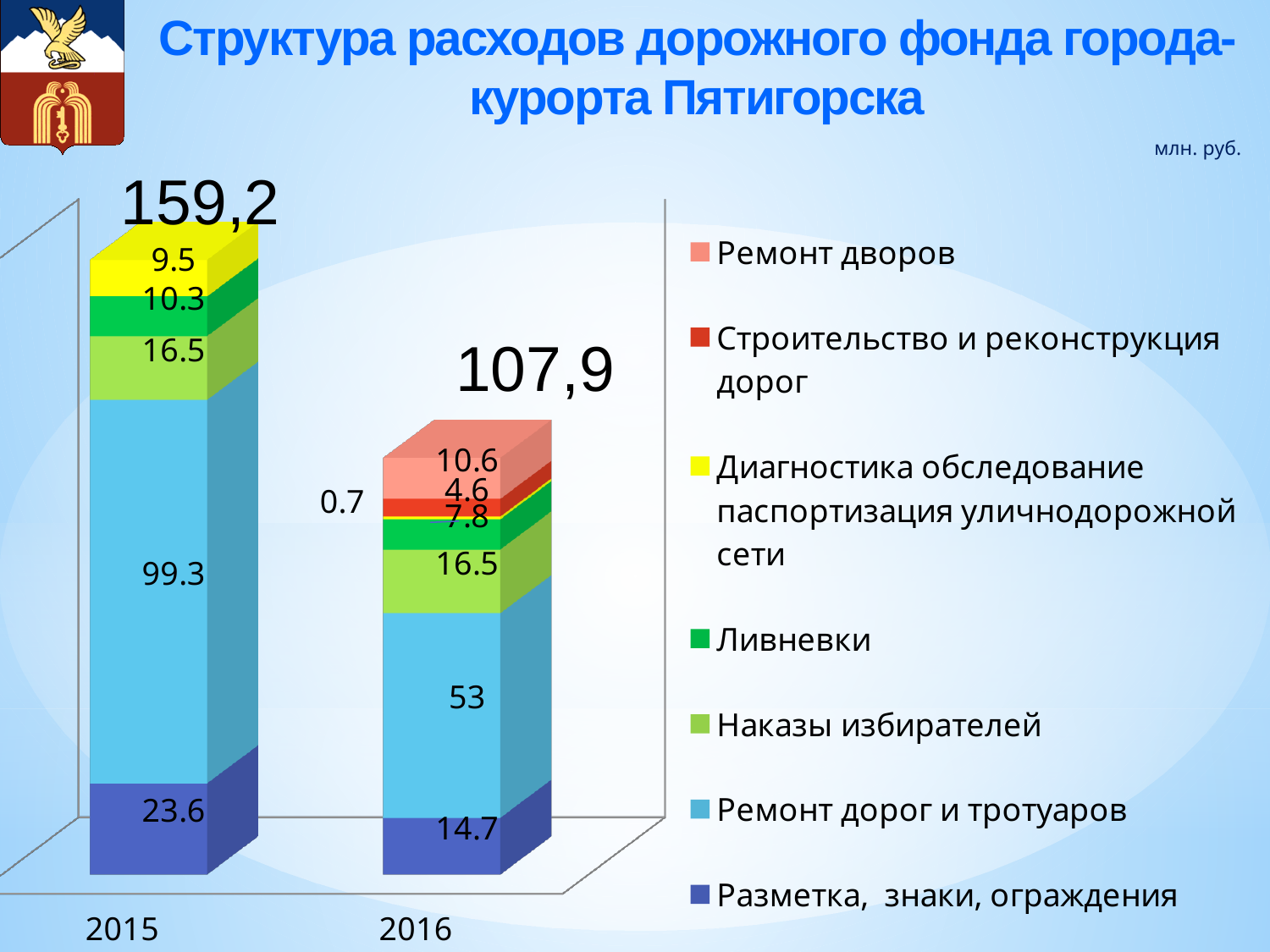
What is the difference between the 'Ремонт дорог и тротуаров' values for 2015 and 2016? 46.3 What is the value for 'Разметка, знаки, ограждения' in 2016? 14.7 What is the value for 'Ремонт дворов' in 2016? 10.6 How many categories (years) are shown on the x axis? 2 What type of chart is shown on the slide? stacked bar chart What is the value for 'Ремонт дорог и тротуаров' in 2015? 99.3 Which series has the largest value in the 2015 bar? Ремонт дорог и тротуаров Which year has the larger value for 'Ливневки', 2015 or 2016? 2015 What is the total value shown above the 2015 bar? 159,2 What is the total value shown above the 2016 bar? 107,9 How many series does the legend list? 7 What is the value for 'Диагностика обследование паспортизация уличнодорожной сети' in 2016? 0.7